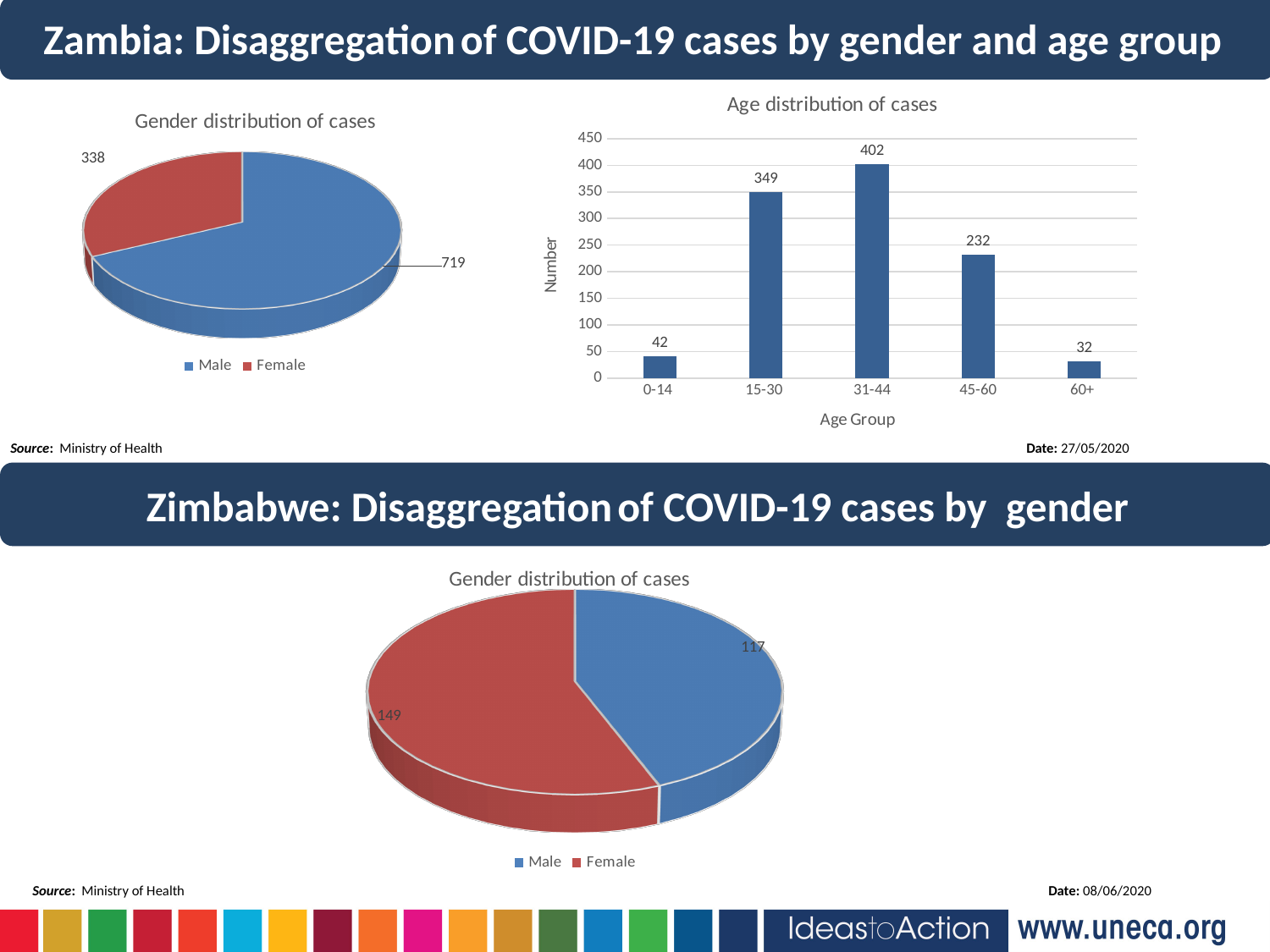
In the Zimbabwe gender distribution pie chart, how many cases are female? 149 In the Zambia age distribution bar chart, how many cases are in the 31-44 age group? 402 In the Zambia age distribution bar chart, which age group has the most cases? 31-44 In the Zambia age distribution bar chart, which age group has the fewest cases? 60+ In the Zimbabwe gender distribution pie chart, which gender has more cases? Female In the Zambia gender distribution pie chart, how many cases are male? 719 In the Zimbabwe gender distribution pie chart, what is the difference between female and male cases? 32 In the Zambia age distribution bar chart, what is the difference in cases between the 15-30 and 45-60 age groups? 117 In the Zambia gender distribution pie chart, which colour represents Female? Red What type of chart is the Zambia age distribution of cases? Bar chart In the Zambia age distribution bar chart, how many age groups are shown on the x axis? 5 In the Zambia gender distribution pie chart, what is the total number of cases across male and female? 1057